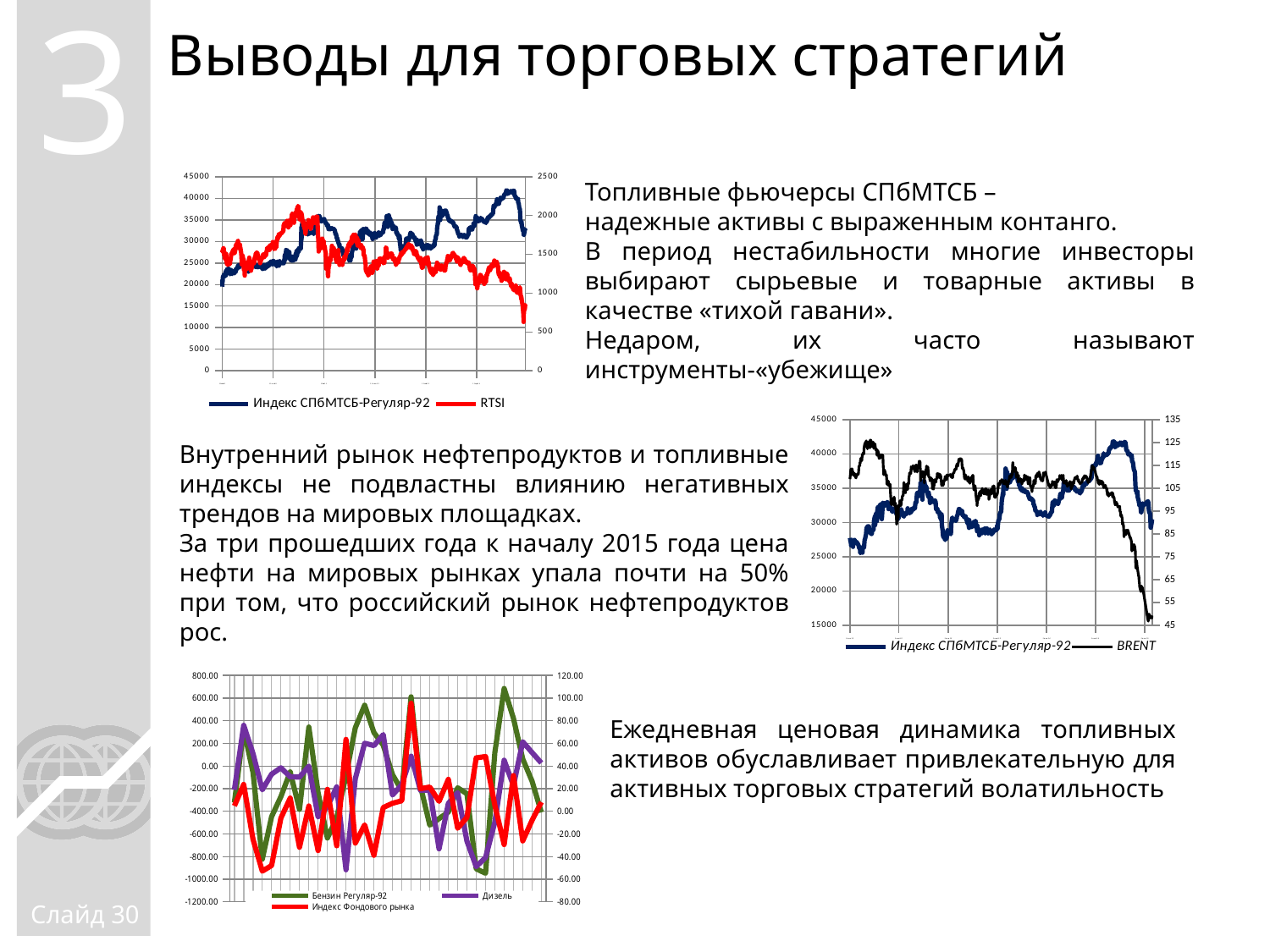
In the middle-right chart, does the BRENT series rise or fall over the last part of the x axis? fall How many series does the legend of the top-left chart list? 2 In the top-left chart, is the starting value of the Индекс СПбМТСБ-Регуляр-92 series (left axis) greater or less than 25000? less How many series does the legend of the middle-right chart list? 2 How many charts are shown on the slide? 3 What type of chart is the top-left chart on the slide? line chart In the middle-right chart, is the final value of the BRENT series (right axis) greater or less than 65? less In the middle-right chart, which series is drawn in black? BRENT In the top-left chart, is the final value of the RTSI series (right axis) greater or less than 1000? less How many series does the legend of the bottom-left chart list? 3 In the top-left chart, does the RTSI series rise or fall at the right end of the x axis? fall In the top-left chart, which series is drawn in red? RTSI